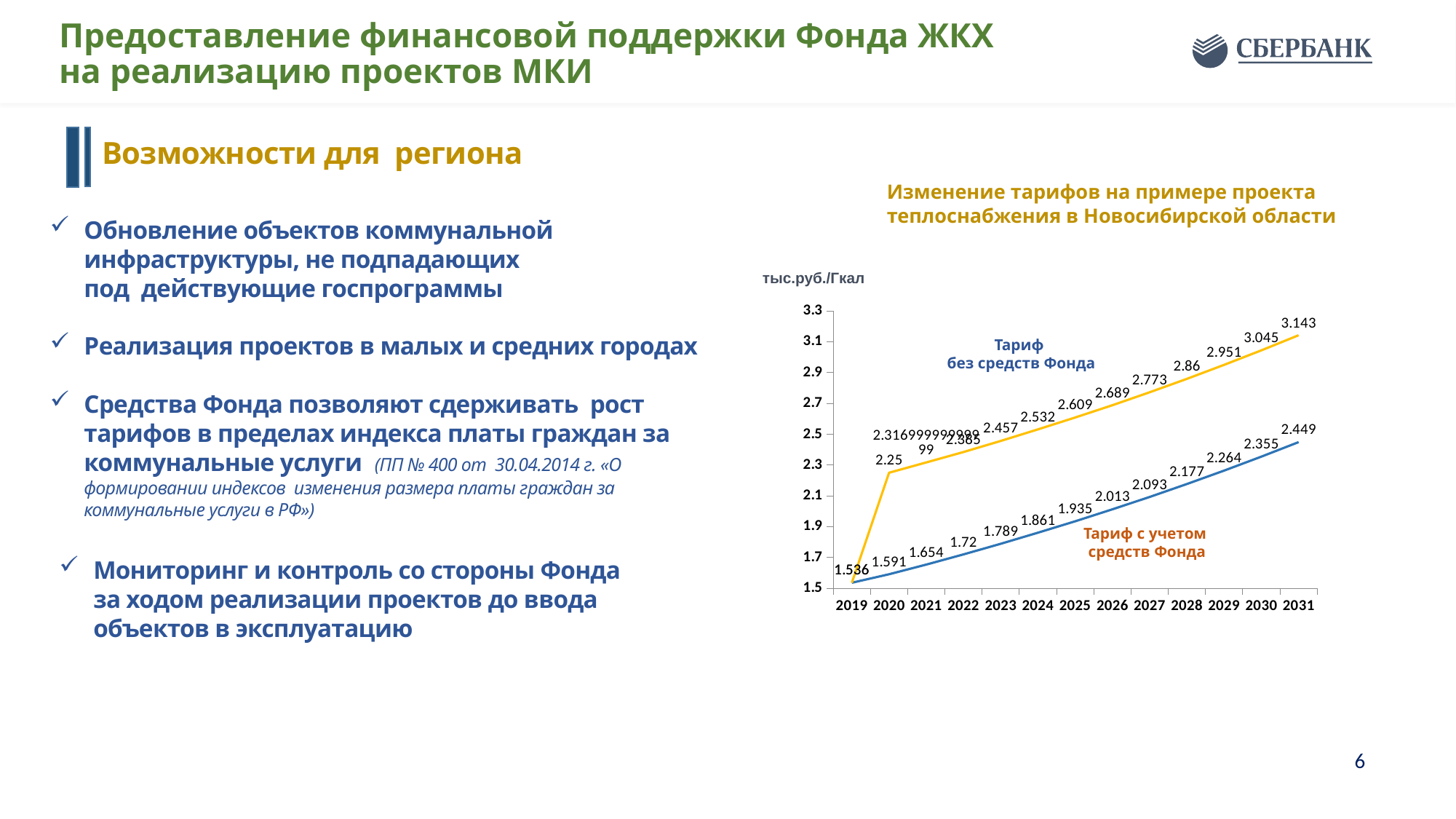
In which year does the "Тариф без средств Фонда" line reach its highest value? 2031 How many years are shown on the x axis of the chart? 13 What is the value of the "Тариф без средств Фонда" line in 2020? 2.25 Which line has the higher value in 2028: "Тариф без средств Фонда" or "Тариф с учетом средств Фонда"? Тариф без средств Фонда Does the "Тариф с учетом средств Фонда" line rise or fall from 2019 to 2031? Rises What is the value of the "Тариф без средств Фонда" line in 2031? 3.143 In which year does the "Тариф с учетом средств Фонда" line reach its lowest value? 2019 What type of chart is shown on the slide? Line chart What is the difference between the two tariff lines in 2031? 0.694 What unit is shown above the chart's y axis? тыс.руб./Гкал What is the value of the "Тариф с учетом средств Фонда" line in 2031? 2.449 What is the value of the "Тариф с учетом средств Фонда" line in 2025? 1.935